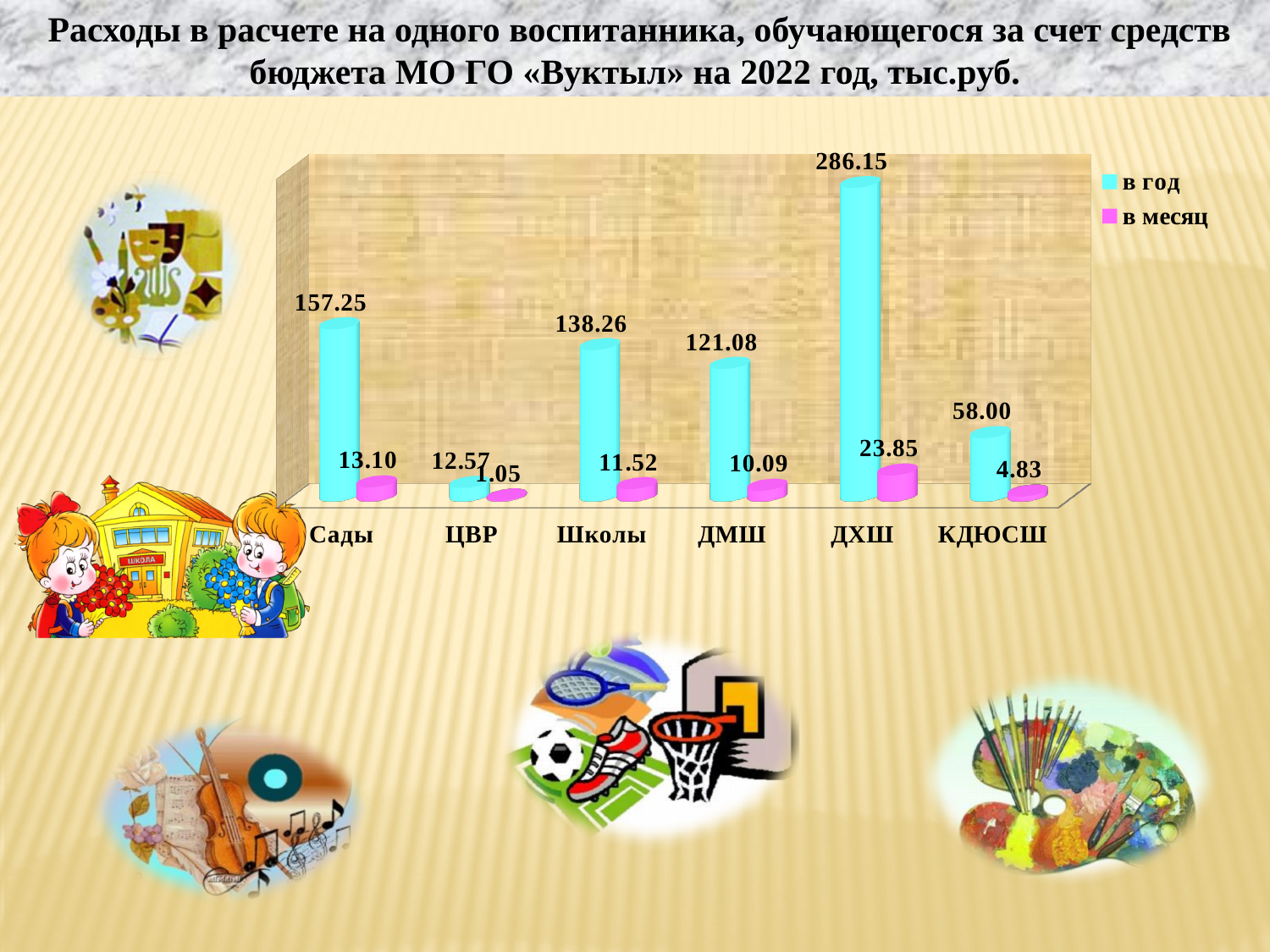
What is the value of "в год" for КДЮСШ? 58.00 What is the value of "в месяц" for ЦВР? 1.05 How many categories are shown on the x axis? 6 Which category has the highest "в год" value? ДХШ Which is larger, the "в год" value for Школы or for ДМШ? Школы What is the value of "в год" for ДХШ? 286.15 Which category has the lowest "в месяц" value? ЦВР How many series does the legend list? 2 What kind of chart is shown on the slide? Bar chart Which colour represents the "в месяц" series in the legend? Magenta (pink) What is the difference between the "в год" values for Сады and Школы? 18.99 What is the value of "в месяц" for Сады? 13.10